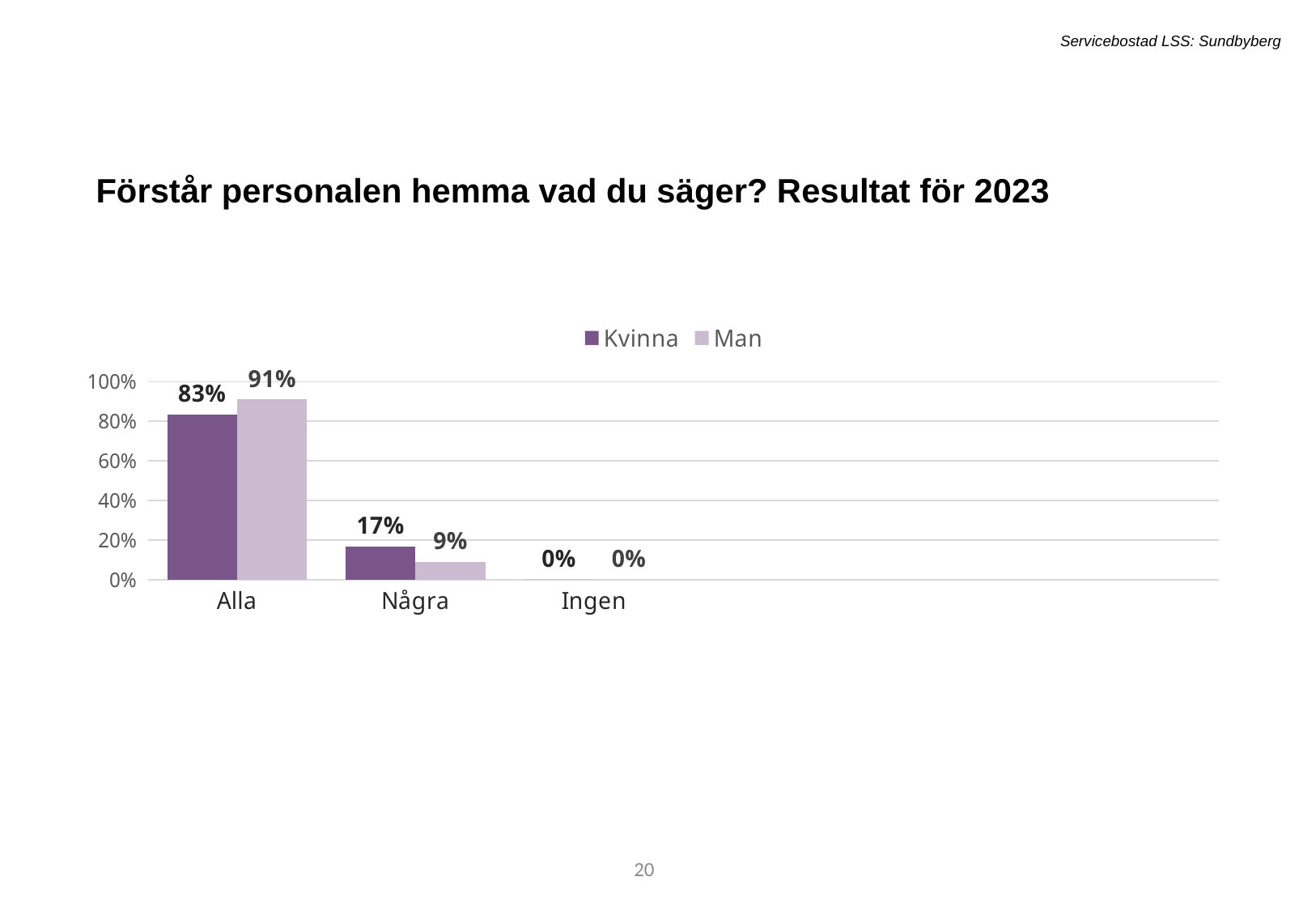
What is the value for Kvinna in the Alla category? 83% How many categories are shown on the x axis? 3 What kind of chart is shown on the slide? Bar chart What is the value for Man in the Några category? 9% What is the value for Man in the Alla category? 91% How many series does the legend list? 2 What is the value for Kvinna in the Ingen category? 0% Which category has the highest value for the Man series? Alla Which is larger in the Några category, Kvinna or Man? Kvinna What is the difference between the Man and Kvinna values in the Alla category? 8% What is the difference between the Kvinna and Man values in the Några category? 8% What is the value for Kvinna in the Några category? 17%